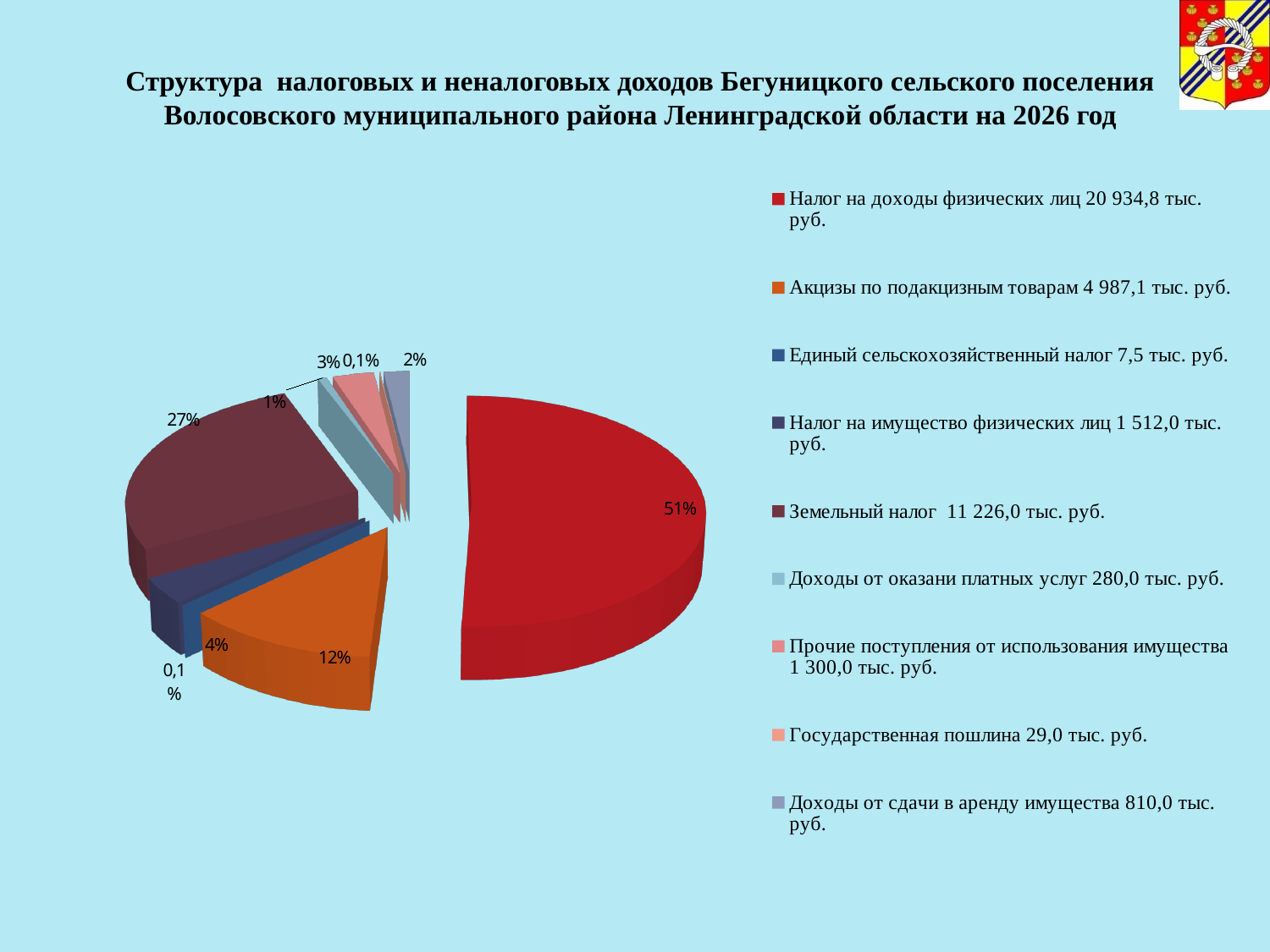
Which is larger: the share for Земельный налог or the share for Акцизы по подакцизным товарам? Земельный налог What share of the pie does Земельный налог have? 27% What share of the pie does Акцизы по подакцизным товарам have? 12% What share of the pie does Налог на доходы физических лиц have? 51% What amount does the legend give for Государственная пошлина? 29,0 тыс. руб. Which category has the largest slice of the pie? Налог на доходы физических лиц How many entries does the legend list? 9 What colour is the slice for Акцизы по подакцизным товарам? orange What amount does the legend give for Земельный налог? 11 226,0 тыс. руб. What is the difference in percentage points between the share for Налог на доходы физических лиц and the share for Земельный налог? 24 What kind of chart is shown on the slide? pie chart